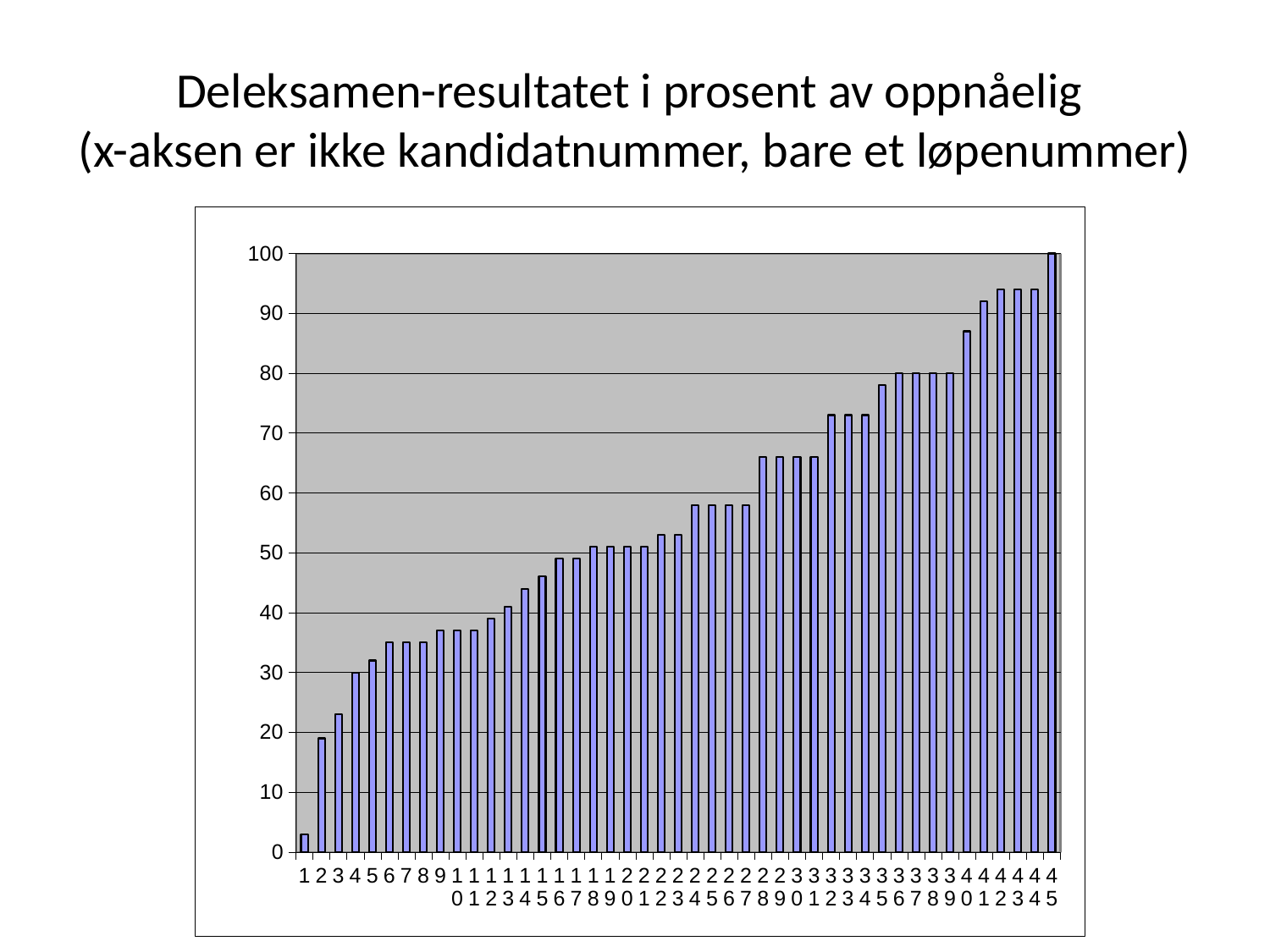
Is the value for x-axis number 15 greater or less than 50? less Which bar is taller, the one at x-axis number 10 or the one at x-axis number 30? 30 Is the value for x-axis number 1 greater or less than 10? less How many bars are plotted in the chart? 45 Which x-axis number has the lowest bar? 1 Which x-axis number has the highest bar? 45 What is the title of the chart on the slide? Deleksamen-resultatet i prosent av oppnåelig (x-aksen er ikke kandidatnummer, bare et løpenummer) Do the values rise or fall along the x axis from 1 to 45? rise Is the value for x-axis number 30 greater or less than 60? greater What kind of chart is shown on the slide? bar chart